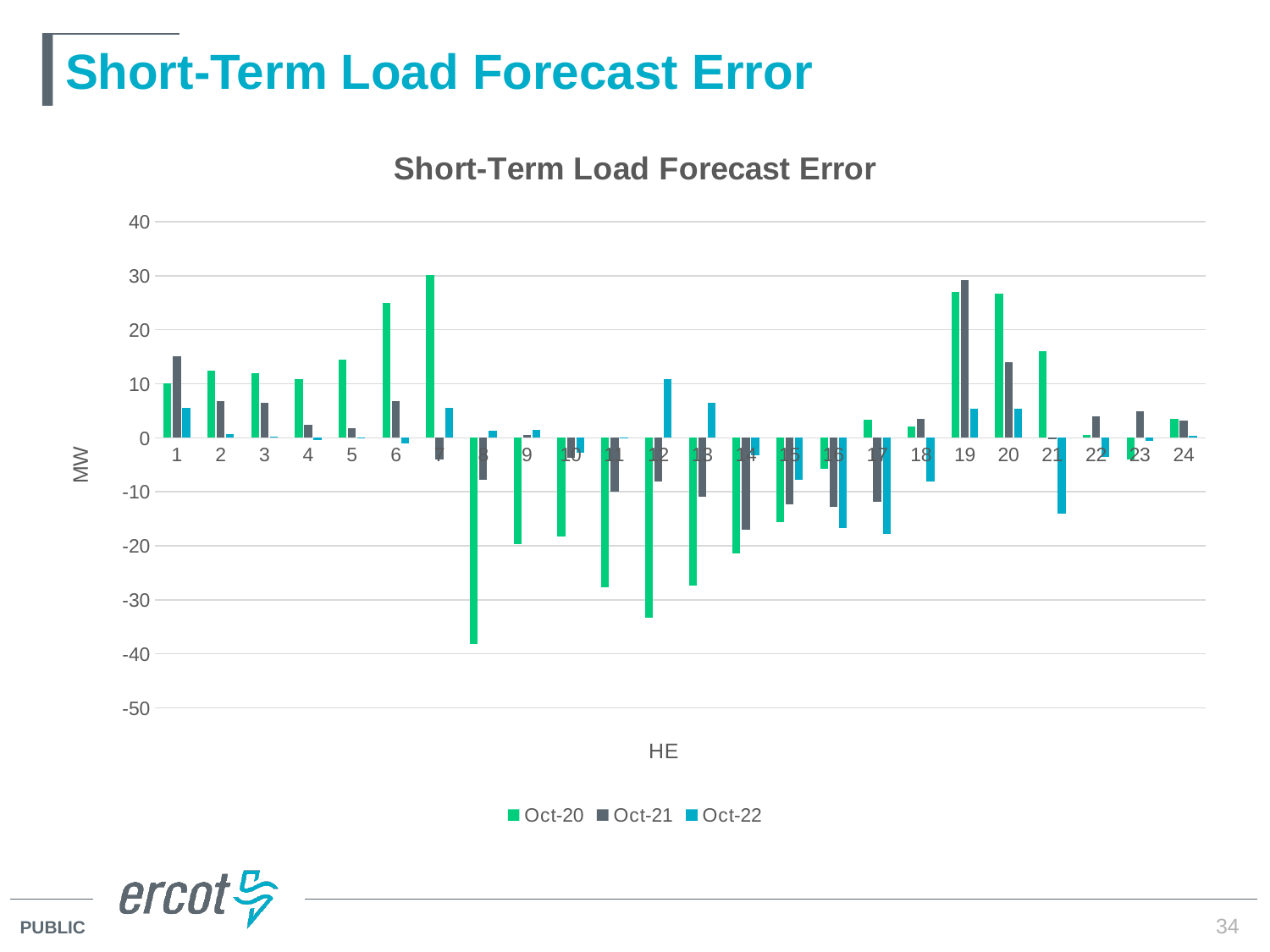
Is the Oct-21 value at HE 19 greater or less than 20? greater How many hour-ending (HE) categories are plotted on the x axis? 24 Is the Oct-20 value at HE 8 greater or less than -30? less At HE 12, which series has the larger value, Oct-20 or Oct-22? Oct-22 For the Oct-21 series, which HE has the highest value? 19 What is the label on the y axis of the chart? MW For the Oct-20 series, which HE has the lowest value? 8 At HE 1, which series has the larger value, Oct-20 or Oct-21? Oct-21 What kind of chart is shown on the slide? bar chart Is the Oct-22 value at HE 21 greater or less than -10? less How many series does the legend list? 3 For the Oct-20 series, which HE has the highest value? 7